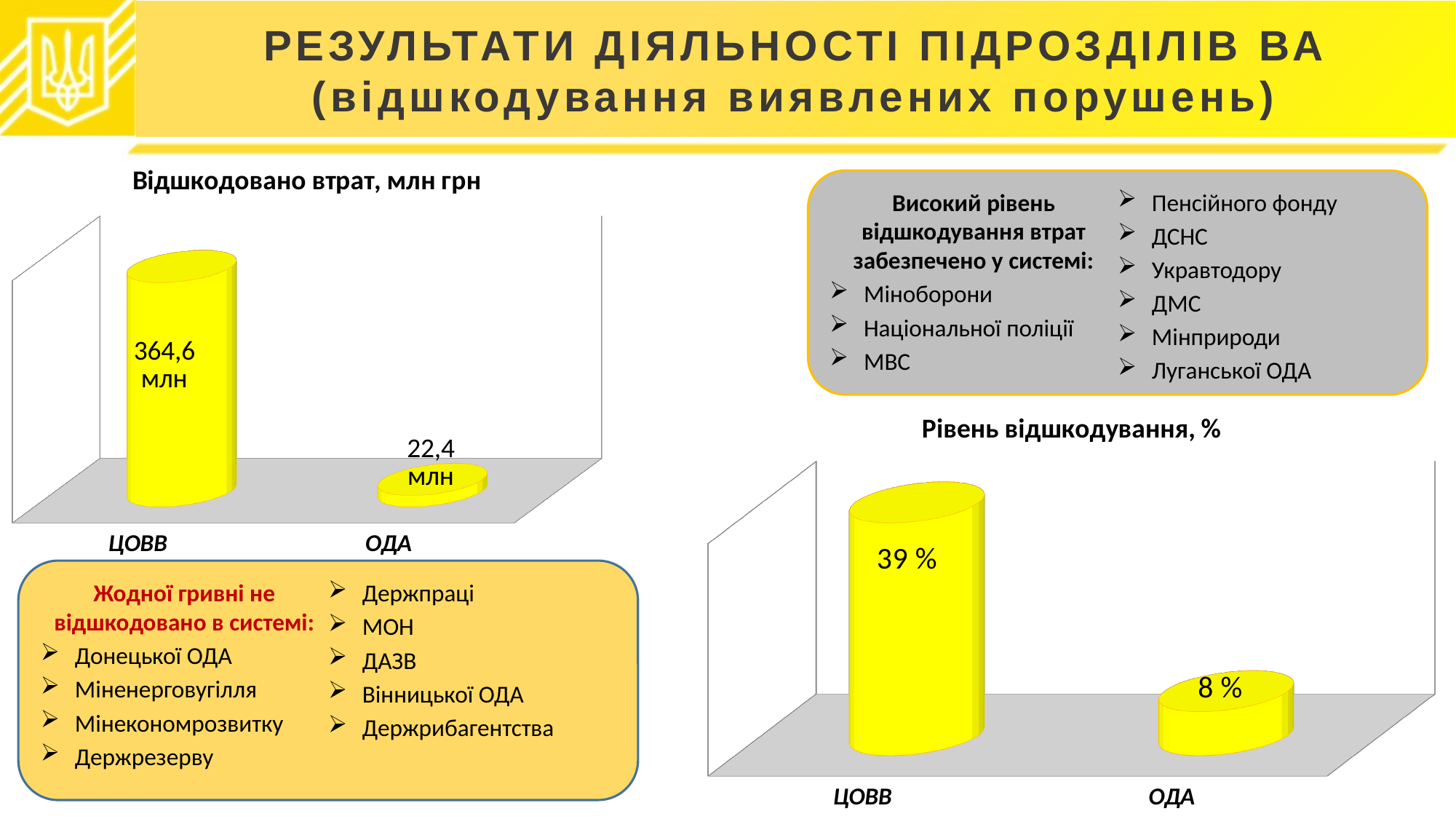
In the chart titled "Відшкодовано втрат, млн грн", what is the value for ЦОВВ? 364,6 млн What kind of chart is the chart titled "Рівень відшкодування, %"? Bar chart In the chart titled "Рівень відшкодування, %", what is the value for ЦОВВ? 39 % In the chart titled "Відшкодовано втрат, млн грн", which category has the highest value? ЦОВВ In the chart titled "Відшкодовано втрат, млн грн", what is the value for ОДА? 22,4 млн In the chart titled "Рівень відшкодування, %", what is the value for ОДА? 8 % In the chart titled "Відшкодовано втрат, млн грн", what is the difference between the values for ЦОВВ and ОДА? 342,2 млн In the chart titled "Рівень відшкодування, %", which is larger, the value for ЦОВВ or the value for ОДА? ЦОВВ How many categories are shown in the chart titled "Відшкодовано втрат, млн грн"? 2 What is the title of the chart on the left side of the slide? Відшкодовано втрат, млн грн In the chart titled "Рівень відшкодування, %", which category has the lowest value? ОДА In the chart titled "Рівень відшкодування, %", what is the difference between the values for ЦОВВ and ОДА? 31 %